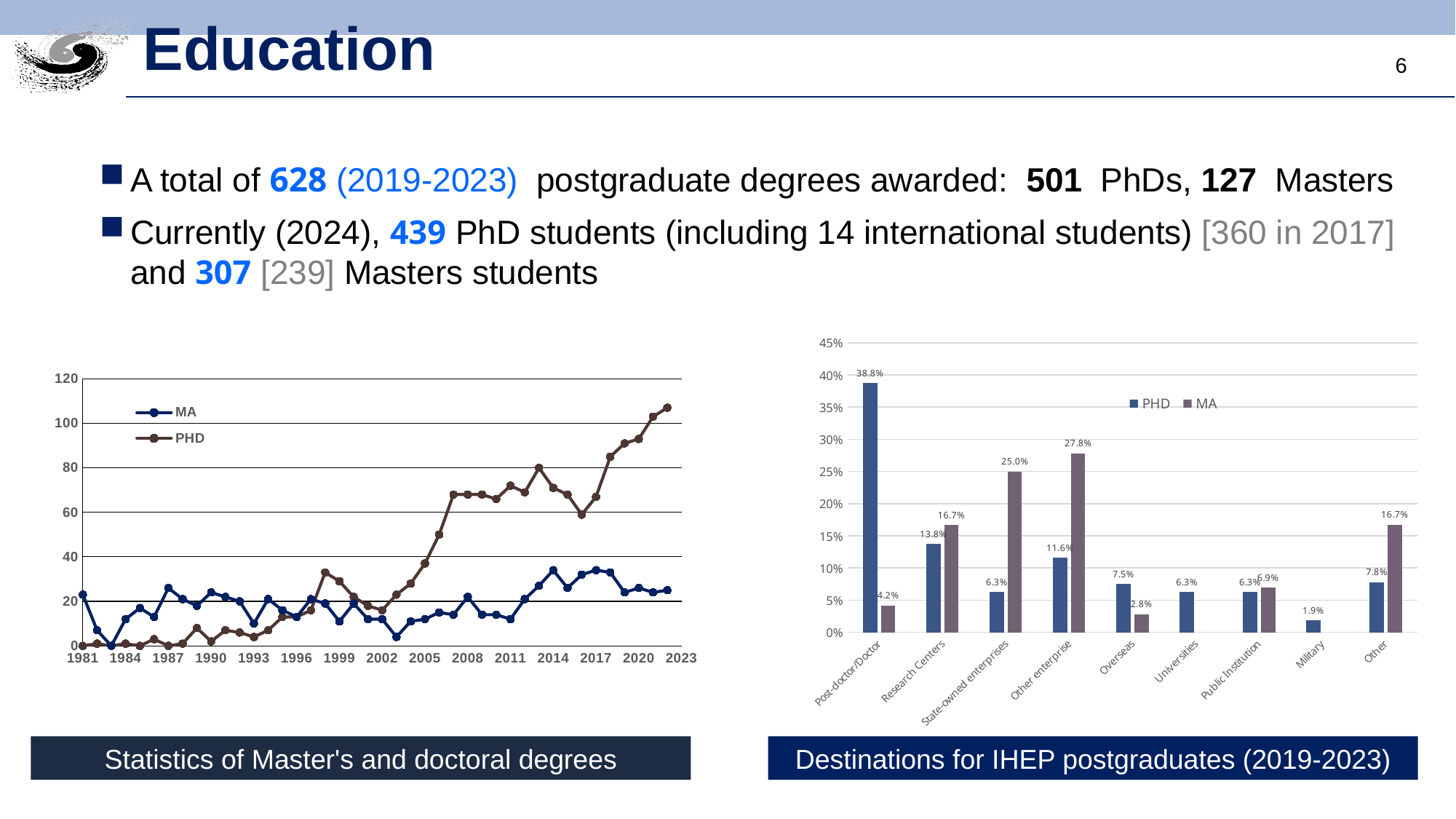
In the 'Destinations for IHEP postgraduates (2019-2023)' chart, what is the MA value for Other enterprise? 27.8% In the 'Destinations for IHEP postgraduates (2019-2023)' chart, which is larger for Research Centers, the PHD value or the MA value? MA What kind of chart is the 'Destinations for IHEP postgraduates (2019-2023)' chart? Bar chart How many series does the legend of the 'Destinations for IHEP postgraduates (2019-2023)' chart list? 2 In the 'Destinations for IHEP postgraduates (2019-2023)' chart, which category has the lowest PHD value? Military In the 'Destinations for IHEP postgraduates (2019-2023)' chart, which category has the highest PHD value? Post-doctor/Doctor In the 'Destinations for IHEP postgraduates (2019-2023)' chart, what is the difference between the MA and PHD values for State-owned enterprises? 18.7% In the 'Statistics of Master's and doctoral degrees' chart, does the PHD series generally rise or fall from 1981 to 2023? Rise In the 'Destinations for IHEP postgraduates (2019-2023)' chart, what is the PHD value for Post-doctor/Doctor? 38.8% How many categories are shown on the x axis of the 'Destinations for IHEP postgraduates (2019-2023)' chart? 9 What kind of chart is the 'Statistics of Master's and doctoral degrees' chart? Line chart